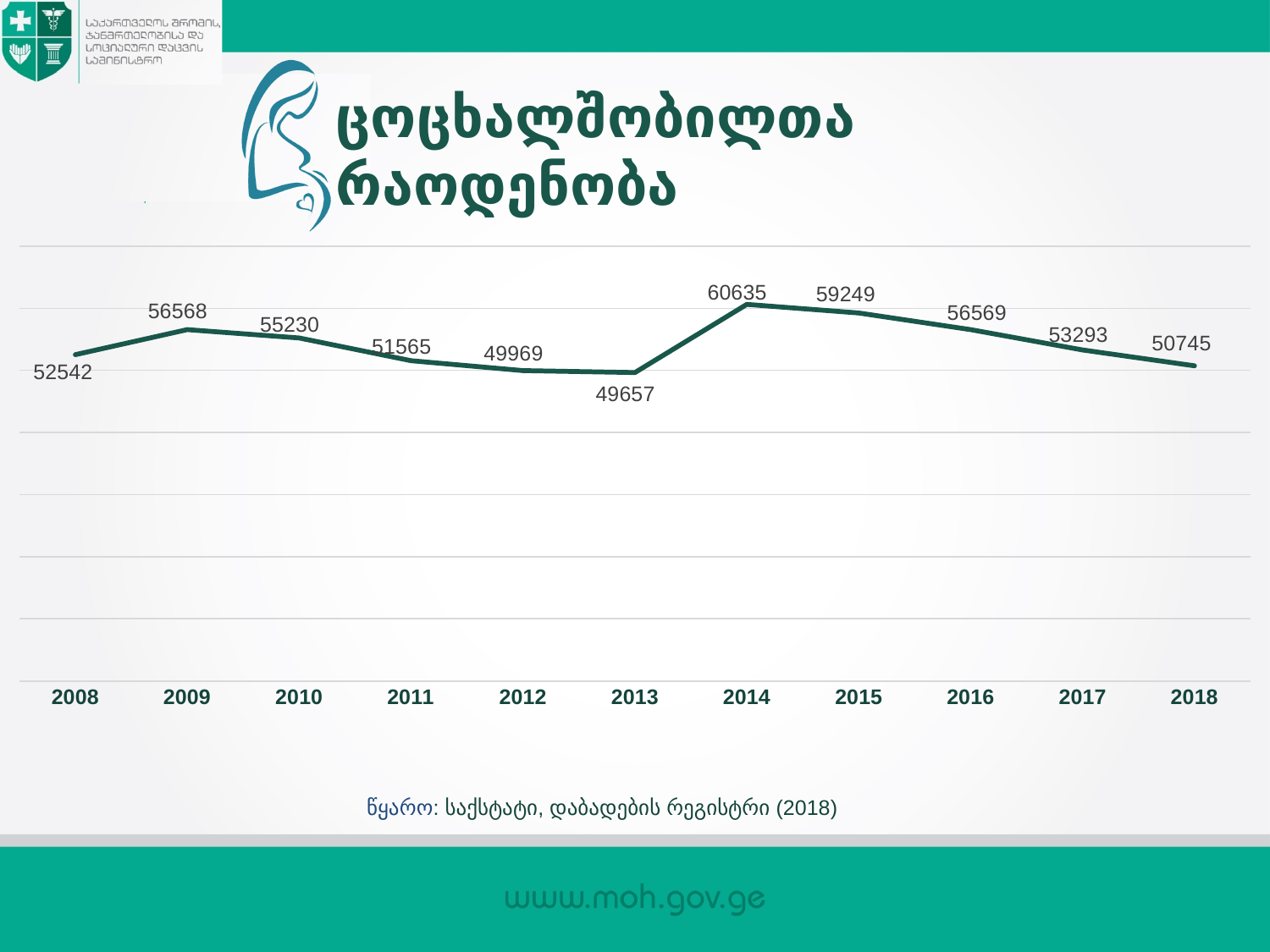
What is the value for 2012? 49969 What kind of chart is shown on the slide? line chart How many years are plotted on the x axis? 11 Which year has the lowest value? 2013 What is the difference between the values for 2009 and 2008? 4026 Do the values rise or fall from 2014 to 2018? fall What is the value for 2014? 60635 What is the value for 2008? 52542 Which year has the highest value? 2014 What is the value for 2018? 50745 Which is larger, the value for 2015 or the value for 2017? 2015 What is the difference between the values for 2014 and 2013? 10978